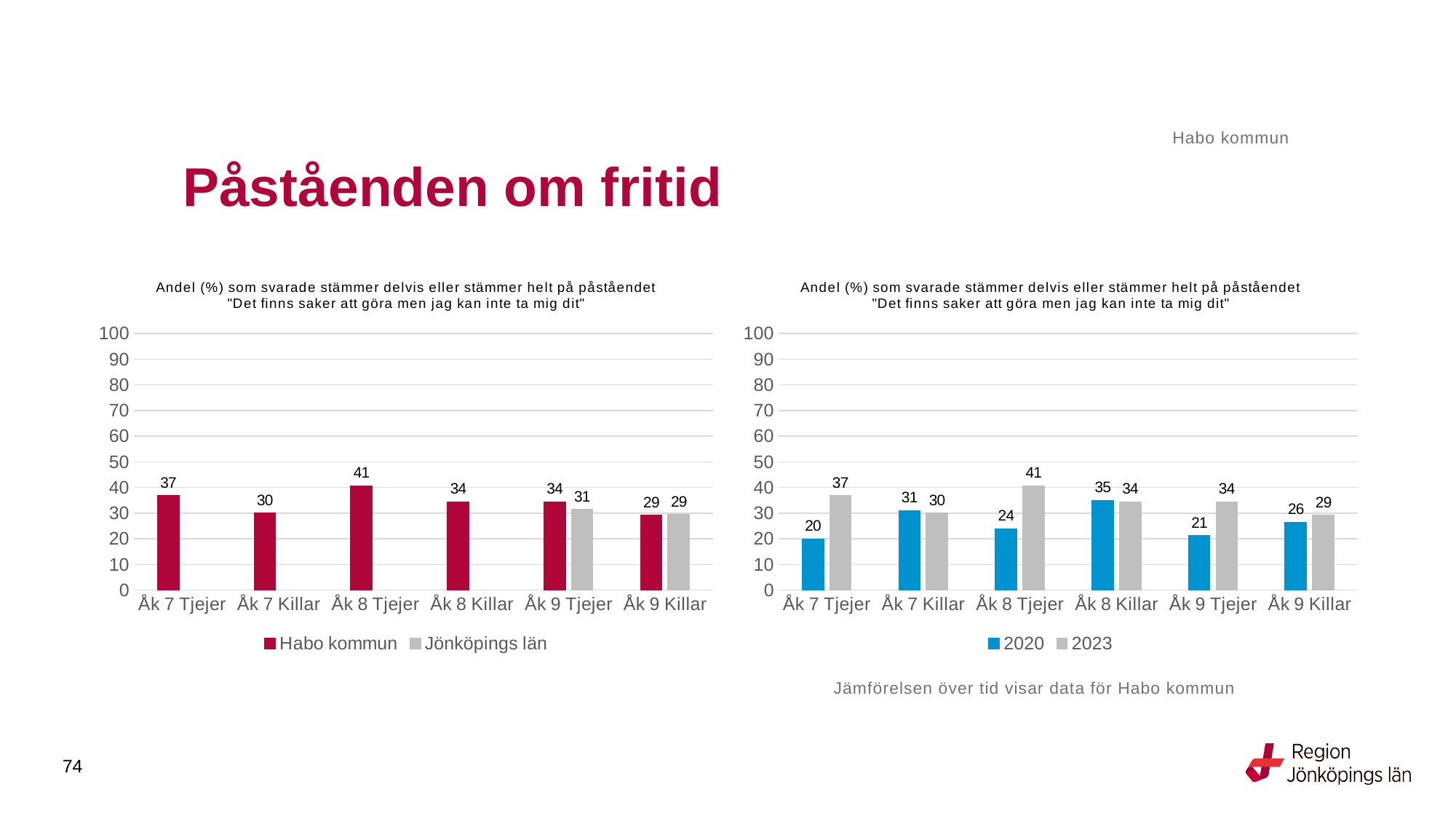
In the left chart, what is the difference between the Habo kommun values for Åk 7 Tjejer and Åk 7 Killar? 7 In the left chart, what is the value for Jönköpings län for Åk 9 Tjejer? 31 In the right chart, what is the 2023 value for Åk 9 Tjejer? 34 In the right chart, which category has the lowest 2020 value? Åk 7 Tjejer In the right chart, what is the 2020 value for Åk 8 Killar? 35 In the left chart, what is the value for Habo kommun for Åk 8 Tjejer? 41 In the right chart, which is larger for Åk 7 Killar: the 2020 value or the 2023 value? 2020 In the left chart, which category has the lowest value for Habo kommun? Åk 9 Killar In the right chart, what is the difference between the 2023 and 2020 values for Åk 8 Tjejer? 17 What kind of chart is the right chart? Bar chart In the left chart, which category has the highest value for Habo kommun? Åk 8 Tjejer In the left chart, how many series does the legend list? 2